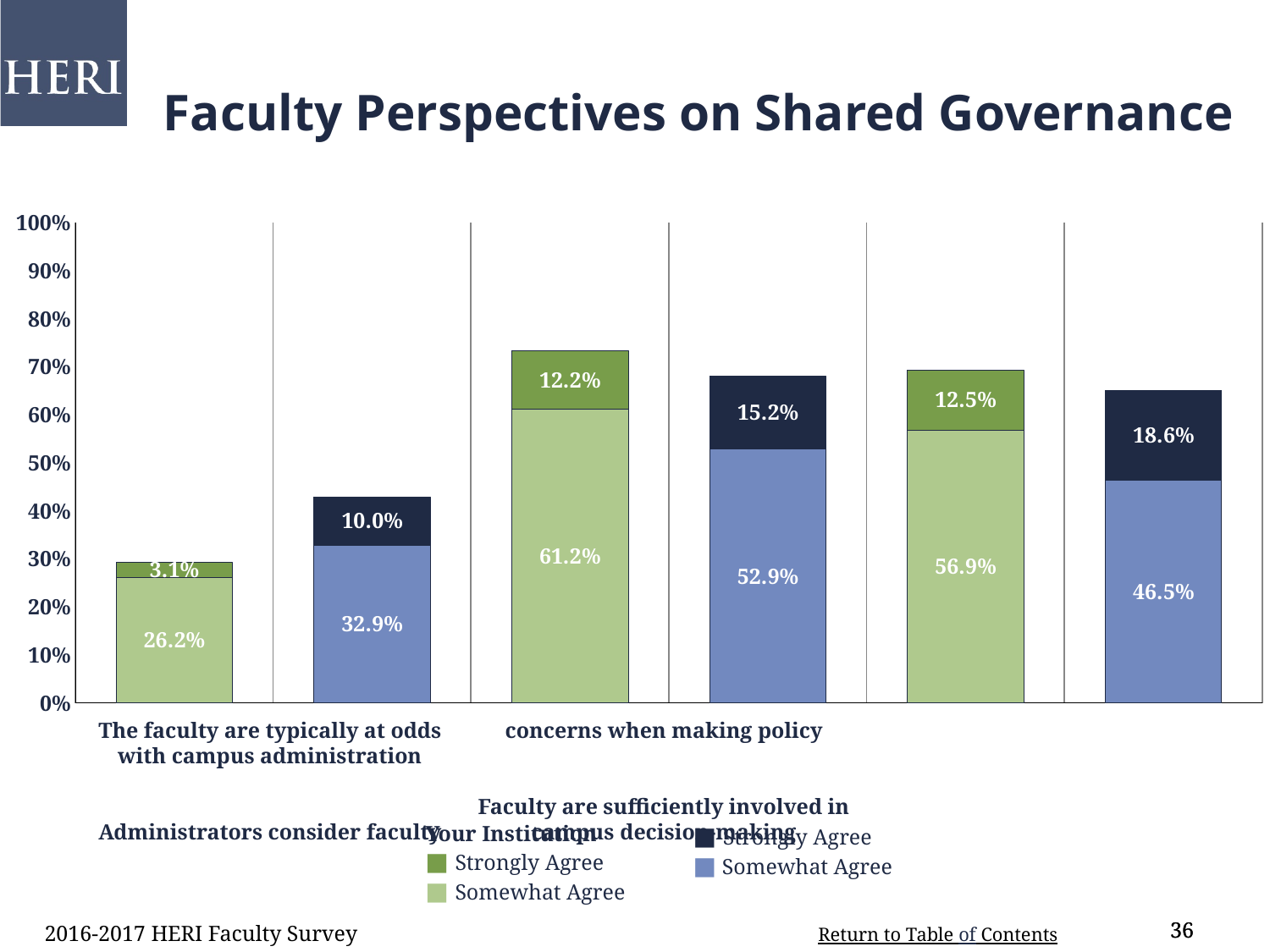
What is the difference between the light blue segment of the fourth bar (52.9%) and the light blue segment of the sixth bar (46.5%)? 6.4% What is the total of the third bar from the left (61.2% plus 12.2%)? 73.4% What kind of chart is shown on the slide? stacked bar chart Is the total height of the first bar from the left greater or less than 30%? less What is the value of the dark navy segment of the second bar from the left? 10.0% What is the value of the light green segment of the third bar from the left? 61.2% What is the value of the dark green segment of the first bar from the left? 3.1% What is the value of the dark navy segment of the sixth bar from the left? 18.6% How many bars are plotted in the chart? 6 What is the total of the second bar from the left (32.9% plus 10.0%)? 42.9% Which bar has the largest dark (top) segment? the sixth bar from the left (18.6%) What is the value of the light green segment of the first bar from the left? 26.2%